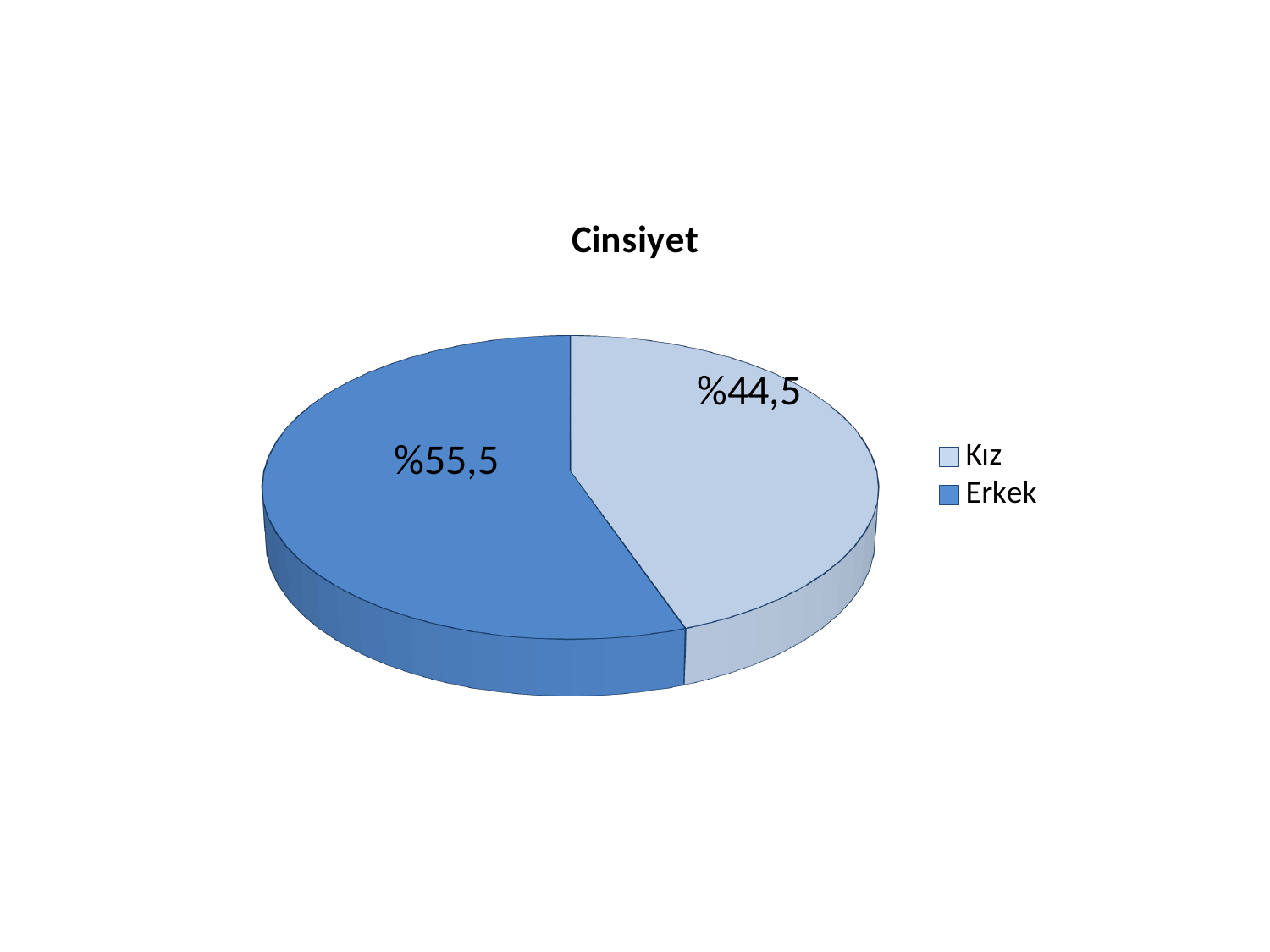
How many categories does the pie chart show? 2 What is the value shown for Kız? %44,5 Which category is shown in the lighter blue colour? Kız What kind of chart is shown on the slide? Pie chart Which is larger, the value for Kız or the value for Erkek? Erkek What is the difference between the Erkek and Kız values? 11 percentage points What is the value shown for Erkek? %55,5 What share of the pie does the Erkek slice represent? %55,5 Which category has the largest share of the pie? Erkek Which category has the smallest share of the pie? Kız What is the title of the chart? Cinsiyet